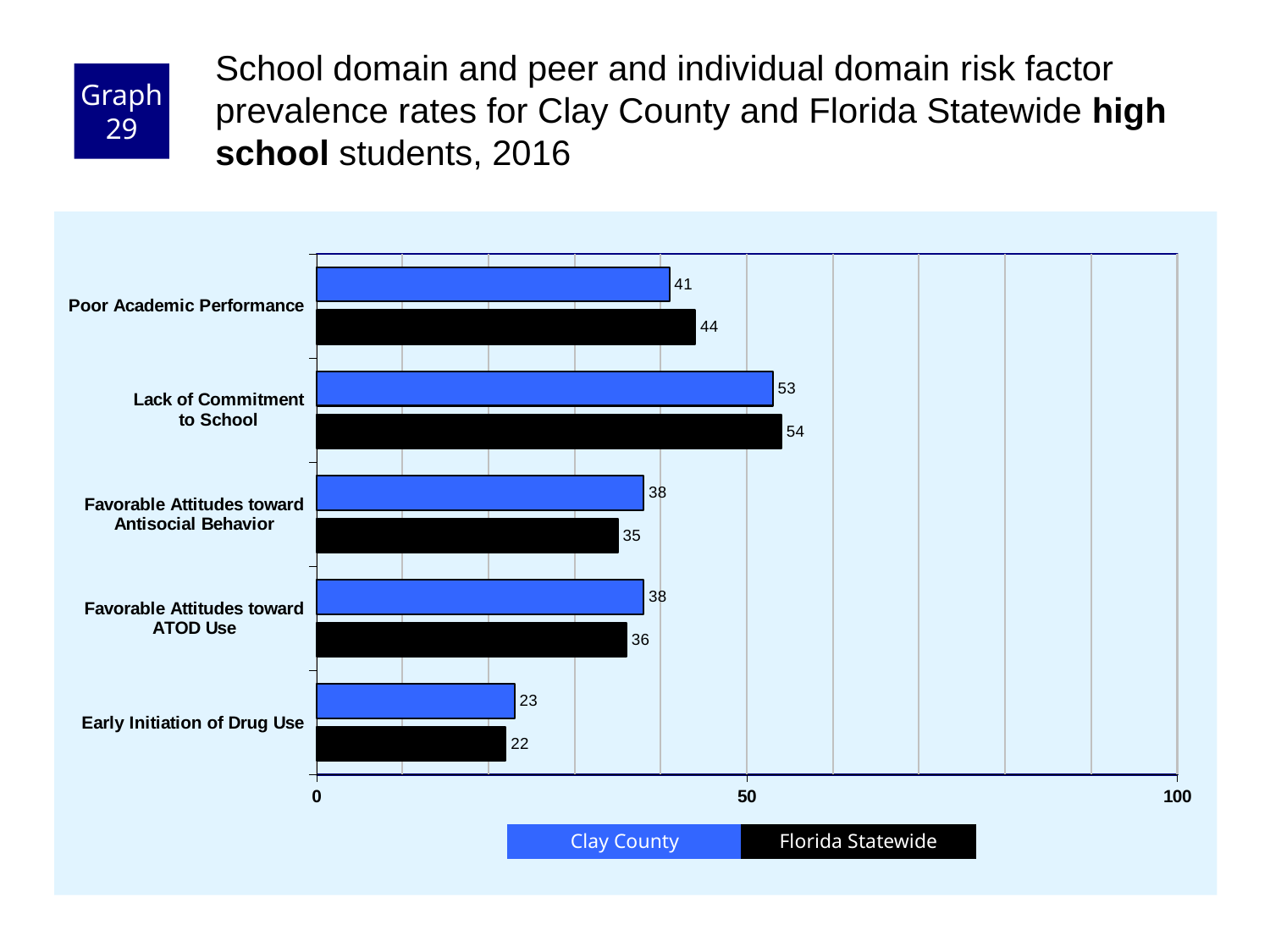
What kind of chart is shown on the slide? Bar chart What is the difference between the Florida Statewide and Clay County values for Poor Academic Performance? 3 How many risk factor categories are shown on the chart? 5 What is the Florida Statewide value for Favorable Attitudes toward Antisocial Behavior? 35 What is the Clay County value for Poor Academic Performance? 41 Which risk factor has the lowest Florida Statewide value? Early Initiation of Drug Use Is the Florida Statewide value for Lack of Commitment to School greater or less than 50? greater For Favorable Attitudes toward ATOD Use, which is larger: the Clay County value or the Florida Statewide value? Clay County How many series does the legend list? 2 What is the Clay County value for Early Initiation of Drug Use? 23 Which risk factor has the highest Clay County value? Lack of Commitment to School What is the Florida Statewide value for Lack of Commitment to School? 54